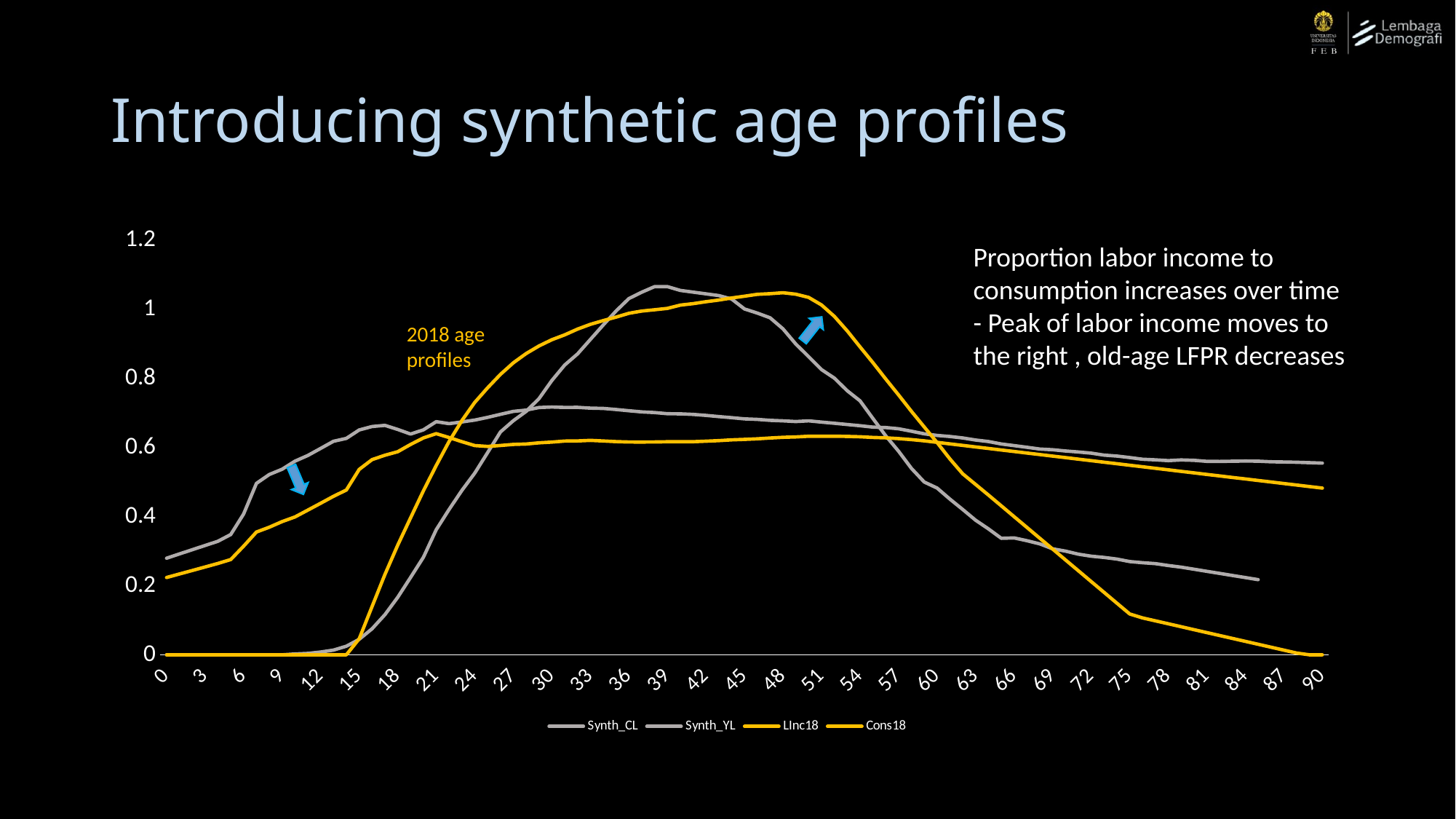
Is the highest value reached by any line greater or less than 1? greater After age 51, does the yellow line that peaks above 1 rise or fall toward age 90? fall At age 90, is the value of the lowest line greater or less than 0.2? less At age 90, is the value of the highest line greater or less than 0.6? less Between ages 15 and 39, do the two lines that start at 0 rise or fall? rise What are the series names listed in the legend? Synth_CL, Synth_YL, LInc18, Cons18 How many series does the legend list? 4 What is the range of ages shown on the x axis? 0 to 90 How many age tick labels are shown on the x axis? 31 What kind of chart is shown on the slide? line chart